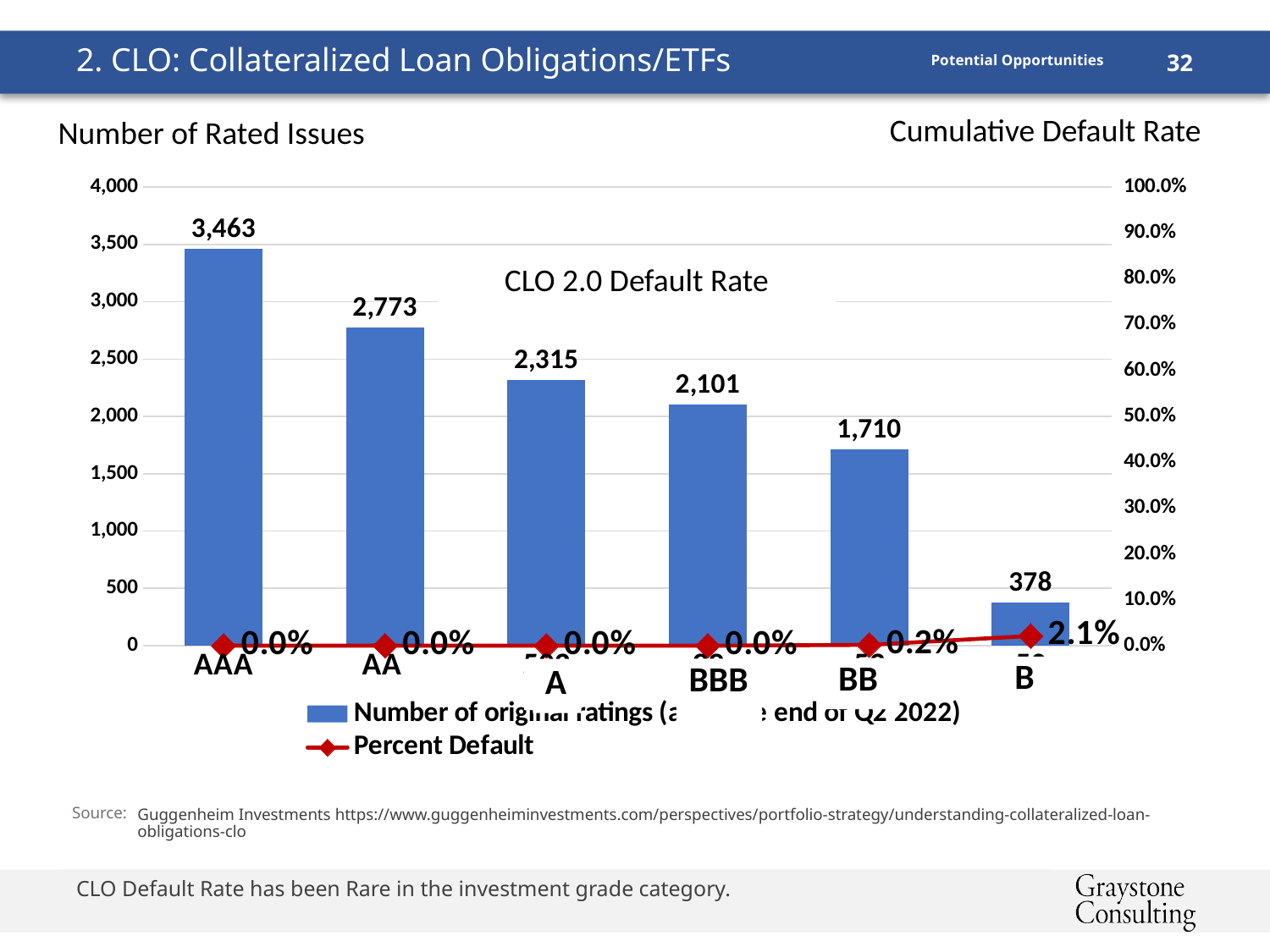
What is the title of the chart? CLO 2.0 Default Rate How many series does the legend list? 2 Which has more rated issues, BBB or BB? BBB What is the Percent Default value for the BB category? 0.2% What is the number of rated issues for the BB category? 1,710 What is the number of rated issues for the AAA category? 3,463 What is the difference in number of rated issues between AA and A? 458 Which rating category has the lowest number of rated issues? B What is the Percent Default value for the B category? 2.1% How many rating categories are shown on the x axis? 6 Which rating category has the highest number of rated issues? AAA Do the bar values rise or fall moving from AAA to B along the x axis? fall